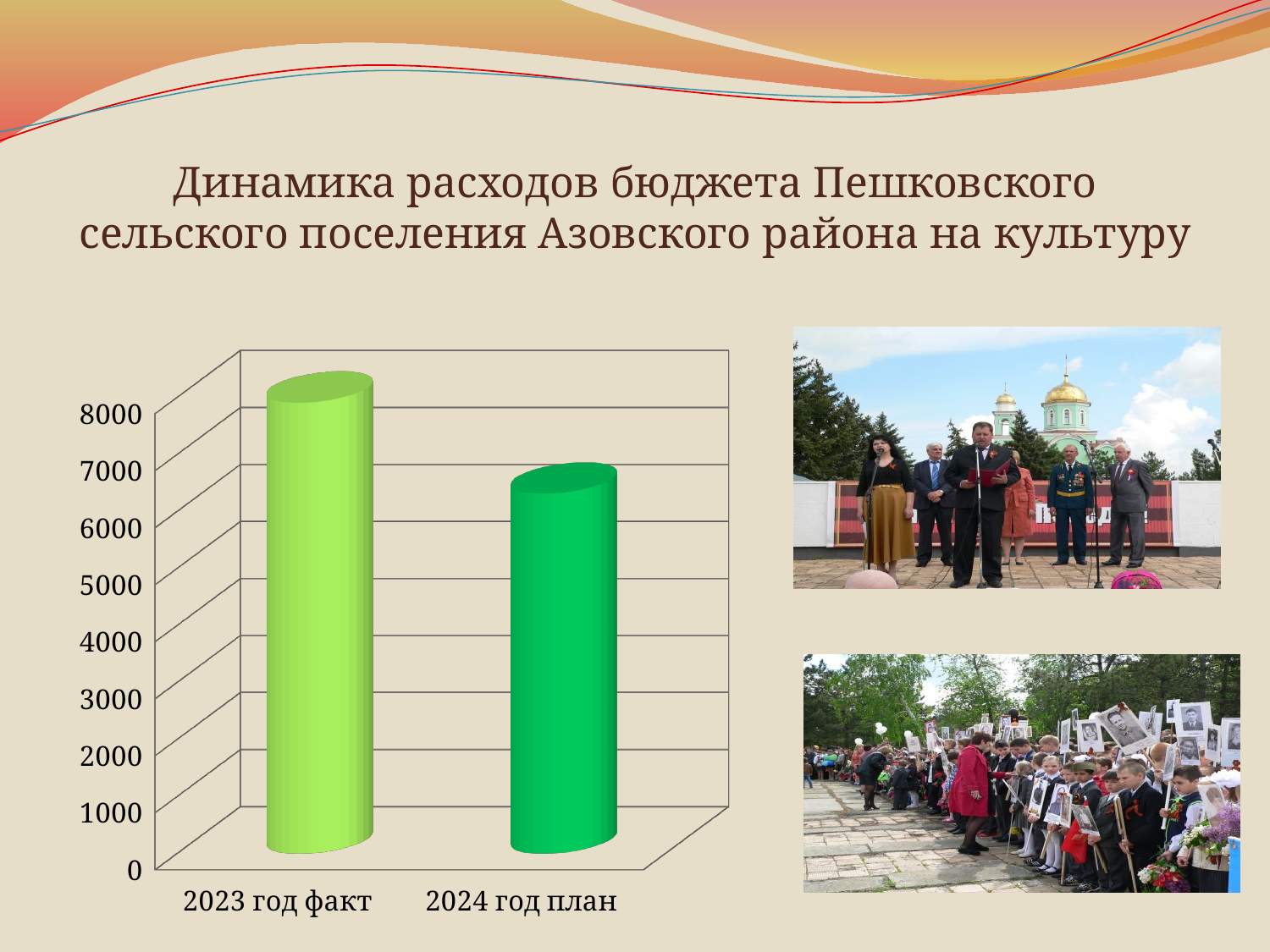
Which category has the lowest value in the chart? 2024 год план Do the values rise or fall from 2023 год факт to 2024 год план? fall Is the value for 2024 год план greater or less than 6000? greater What kind of chart is shown on the slide? bar chart Is the value for 2023 год факт greater or less than 7000? greater How many categories are shown on the x axis of the chart? 2 What is the title of the slide containing the chart? Динамика расходов бюджета Пешковского сельского поселения Азовского района на культуру Is the value for 2024 год план greater or less than 8000? less Which is larger, the value for 2023 год факт or the value for 2024 год план? 2023 год факт Which category has the highest value in the chart? 2023 год факт What is the highest value labelled on the vertical axis of the chart? 8000